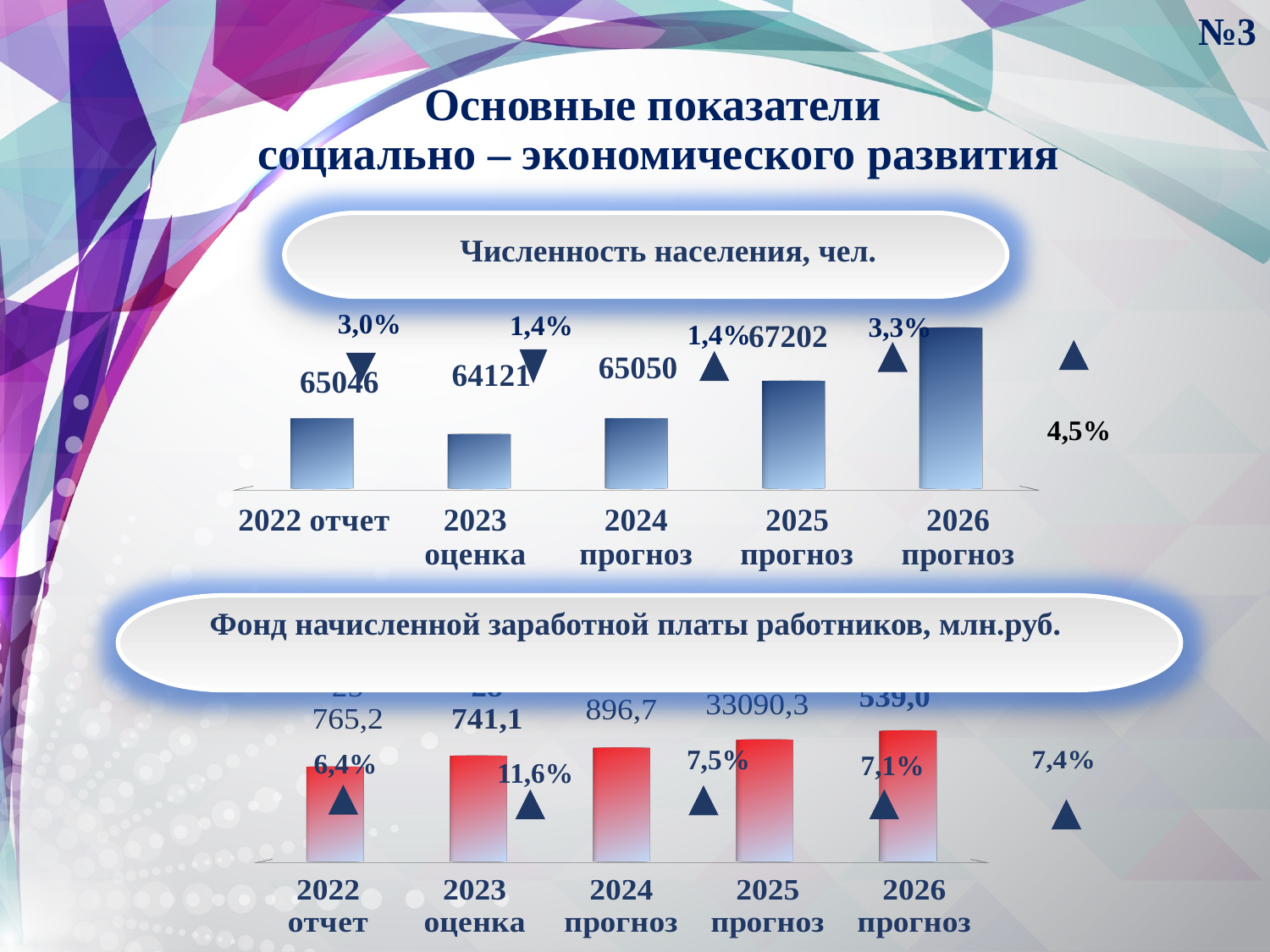
In the top chart (Численность населения, чел.), which is larger: the value for 2025 прогноз or 2023 оценка? 2025 прогноз What kind of chart is the bottom chart (Фонд начисленной заработной платы работников, млн.руб.)? bar chart How many categories are shown in the top chart (Численность населения, чел.)? 5 What is the title of the top chart on the slide? Численность населения, чел. In the top chart (Численность населения, чел.), what is the difference between the values for 2025 прогноз and 2024 прогноз? 2152 In the top chart (Численность населения, чел.), which category has the highest bar? 2026 прогноз In the top chart (Численность населения, чел.), what is the value for 2022 отчет? 65046 In the top chart (Численность населения, чел.), which category has the lowest value? 2023 оценка In the top chart (Численность населения, чел.), what is the value for 2025 прогноз? 67202 In the bottom chart (Фонд начисленной заработной платы работников, млн.руб.), do the bar values rise or fall from 2022 to 2026? rise In the top chart (Численность населения, чел.), what is the value for 2023 оценка? 64121 In the top chart (Численность населения, чел.), what is the difference between the values for 2022 отчет and 2023 оценка? 925